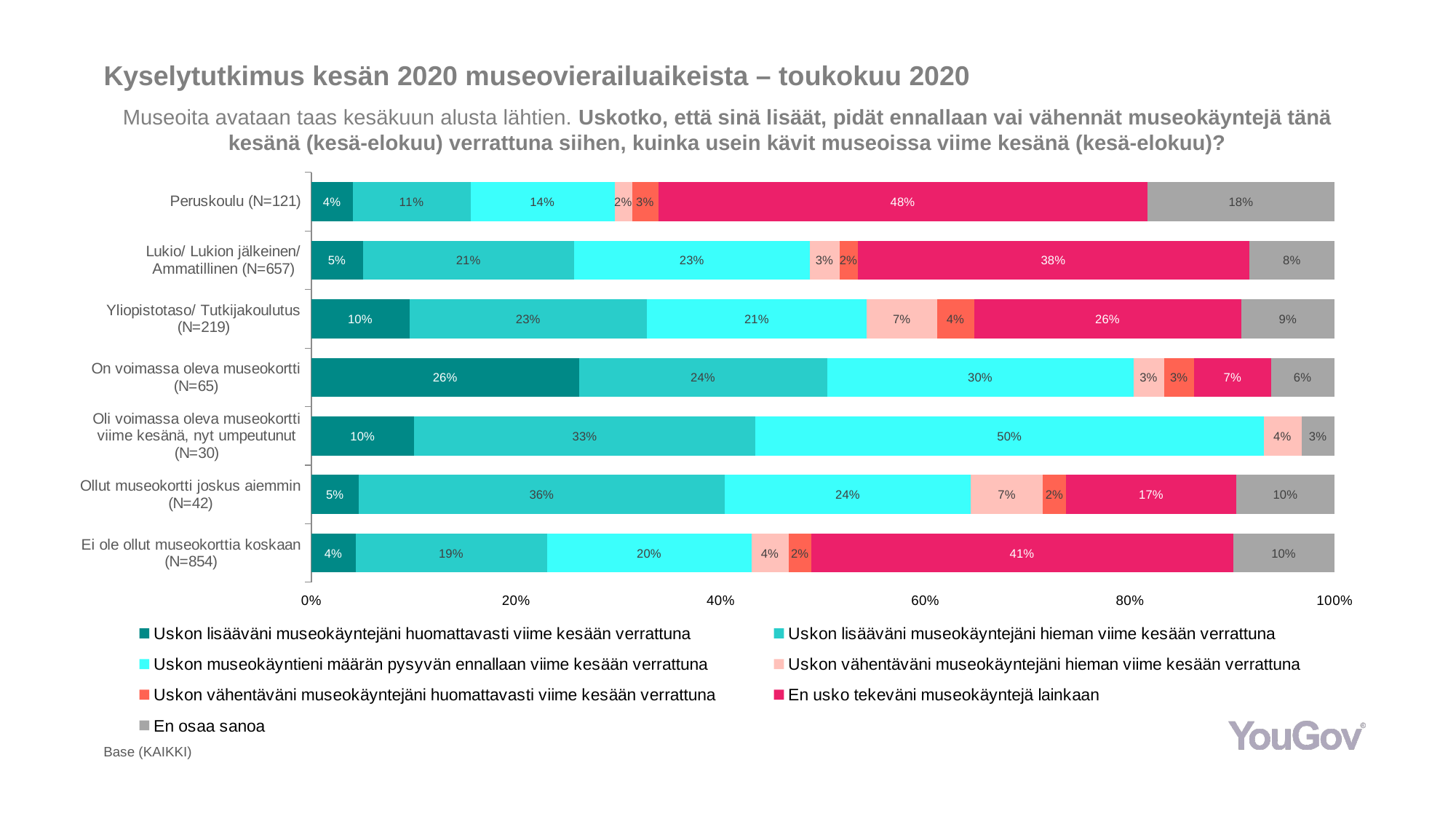
What is the value of 'En usko tekeväni museokäyntejä lainkaan' for Peruskoulu (N=121)? 48% Which colour represents 'En osaa sanoa' in the chart? Grey Which category has the highest value for 'En usko tekeväni museokäyntejä lainkaan'? Peruskoulu (N=121) What kind of chart is shown on the slide? Stacked bar chart How many categories (bars) are shown in the chart? 7 How many series does the legend list? 7 What is the value of 'Uskon museokäyntieni määrän pysyvän ennallaan viime kesään verrattuna' for 'Oli voimassa oleva museokortti viime kesänä, nyt umpeutunut (N=30)'? 50% Which is larger: the 'Uskon lisääväni museokäyntejäni hieman viime kesään verrattuna' value for 'Ollut museokortti joskus aiemmin (N=42)' or for 'Yliopistotaso/ Tutkijakoulutus (N=219)'? Ollut museokortti joskus aiemmin (N=42) What is the difference between the 'En usko tekeväni museokäyntejä lainkaan' values for Peruskoulu (N=121) and 'Ei ole ollut museokorttia koskaan (N=854)'? 7% What is the value of 'Uskon lisääväni museokäyntejäni huomattavasti viime kesään verrattuna' for 'On voimassa oleva museokortti (N=65)'? 26% What is the 'En osaa sanoa' value for 'Lukio/ Lukion jälkeinen/ Ammatillinen (N=657)'? 8% Which category has the lowest value for 'Uskon lisääväni museokäyntejäni hieman viime kesään verrattuna'? Peruskoulu (N=121)